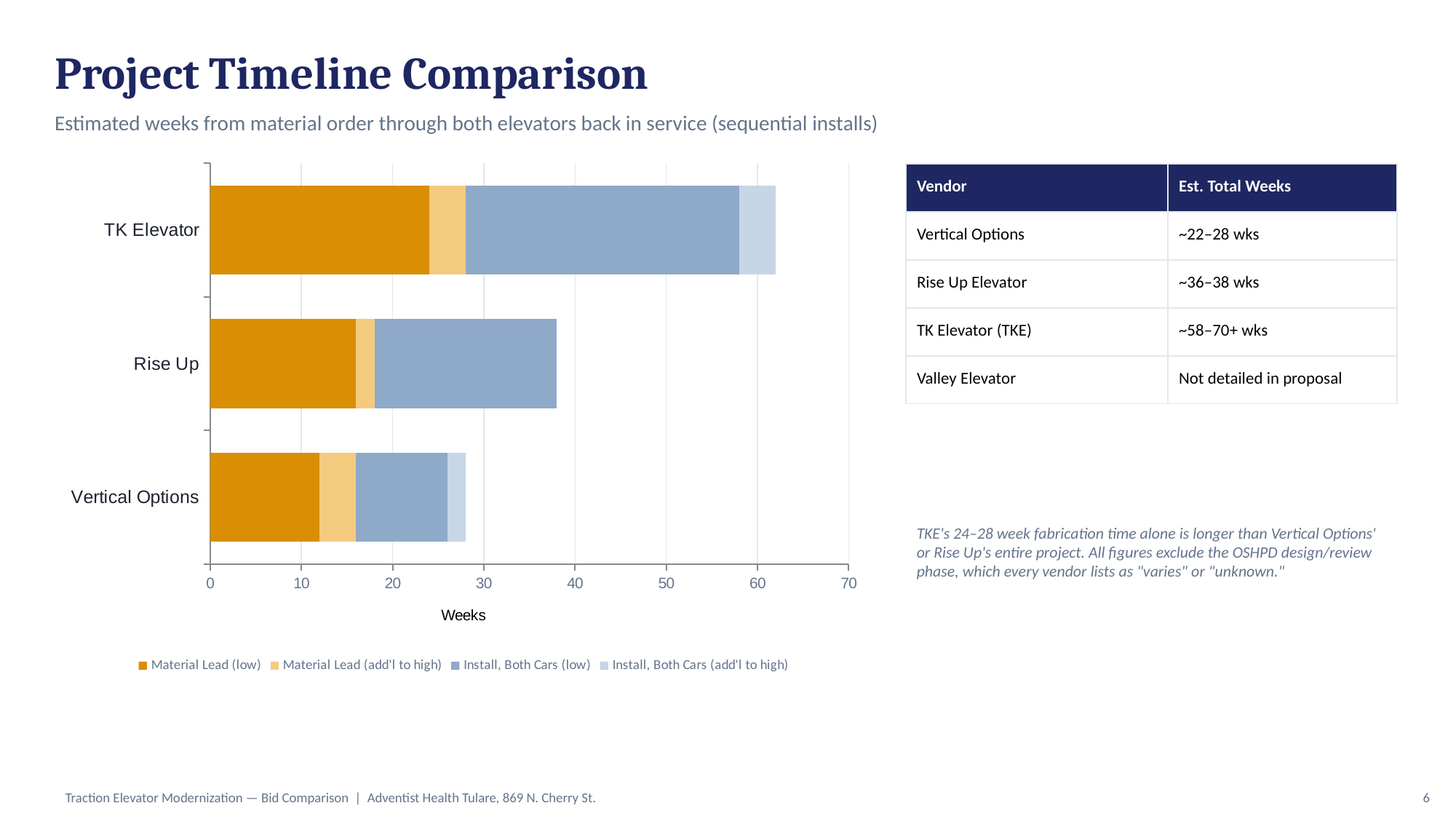
What kind of chart is shown on the slide? Stacked bar chart Which vendor's total bar is longer, Rise Up or Vertical Options? Rise Up Is the total bar length for TK Elevator greater or less than 50 weeks? greater Is the Material Lead (low) segment for Rise Up greater or less than 20 weeks? less What is the label on the horizontal axis of the chart? Weeks How many vendors are plotted on the chart? 3 Is the Material Lead (low) segment for TK Elevator greater or less than 20 weeks? greater Which vendor has the longest total bar on the chart? TK Elevator How many series does the chart legend list? 4 Which vendor has the shortest total bar on the chart? Vertical Options